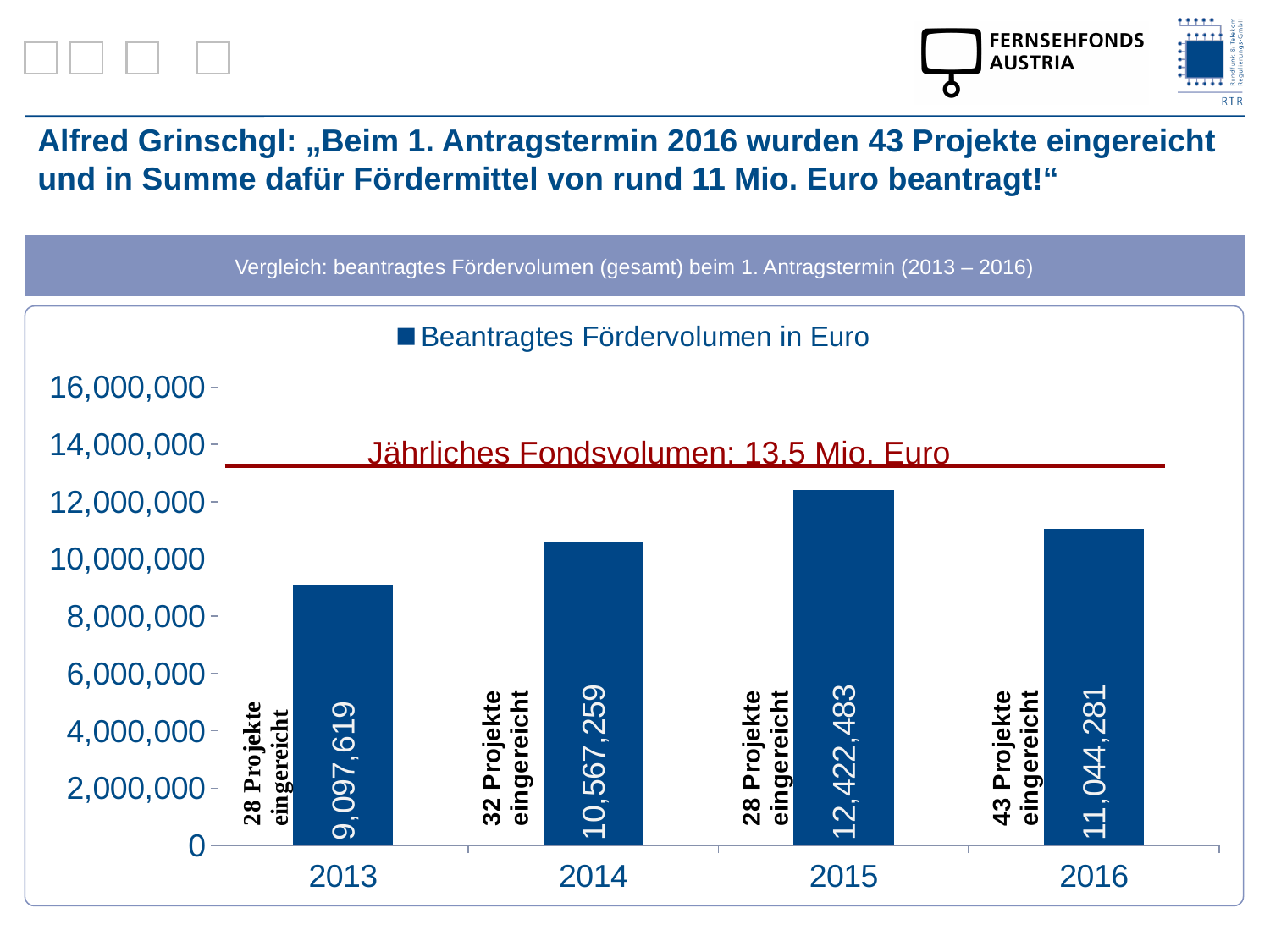
What type of chart is shown on the slide? bar chart How many series does the chart legend list? 1 Which year has the lowest requested funding volume? 2013 Which year has a larger requested funding volume, 2014 or 2016? 2016 What is the requested funding volume for 2016? 11,044,281 How many projects were submitted in 2016 according to the chart annotation? 43 Projekte What is the difference between the requested funding volume in 2015 and in 2014? 1,855,224 Which year has the highest requested funding volume? 2015 How many years are shown on the x axis of the chart? 4 What is the requested funding volume (Beantragtes Fördervolumen) for 2015? 12,422,483 What is the requested funding volume for 2013? 9,097,619 Is the requested funding volume for 2014 greater or less than 10,000,000? greater